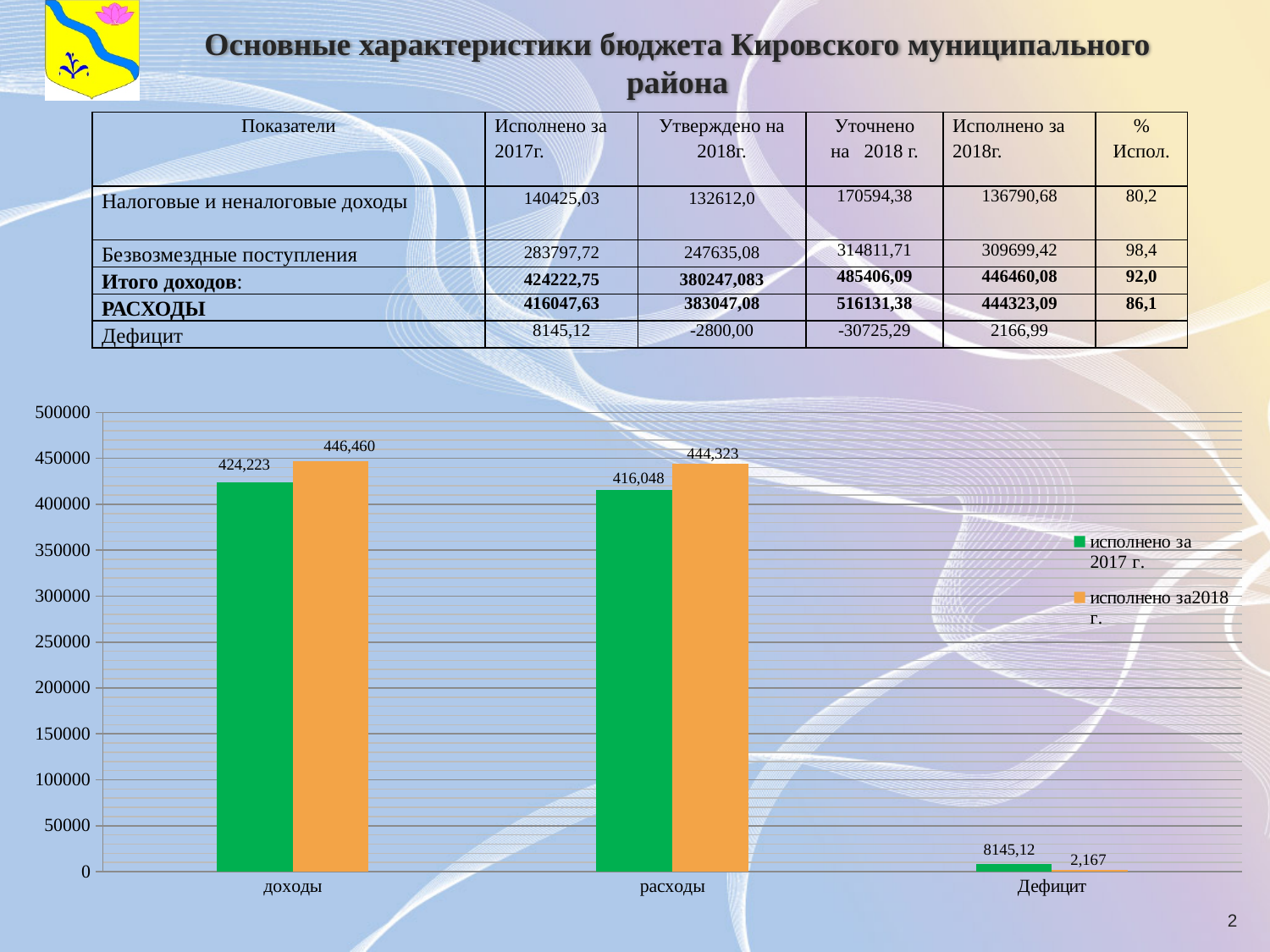
How many categories are shown on the x axis of the chart? 3 What is the difference between the исполнено за2018 г. and исполнено за 2017 г. values for доходы? 22,237 For расходы, which series has the larger value: исполнено за 2017 г. or исполнено за2018 г.? исполнено за2018 г. What type of chart is shown on the slide? bar chart What is the value for доходы in the series исполнено за 2017 г.? 424,223 Is the value for расходы in the series исполнено за 2017 г. greater or less than 400000? greater Which category has the lowest value in the series исполнено за2018 г.? Дефицит What is the value for Дефицит in the series исполнено за 2017 г.? 8145,12 What is the value for расходы in the series исполнено за2018 г.? 444,323 How many series does the chart legend list? 2 Which category has the highest value in the series исполнено за 2017 г.? доходы What is the value for Дефицит in the series исполнено за2018 г.? 2,167